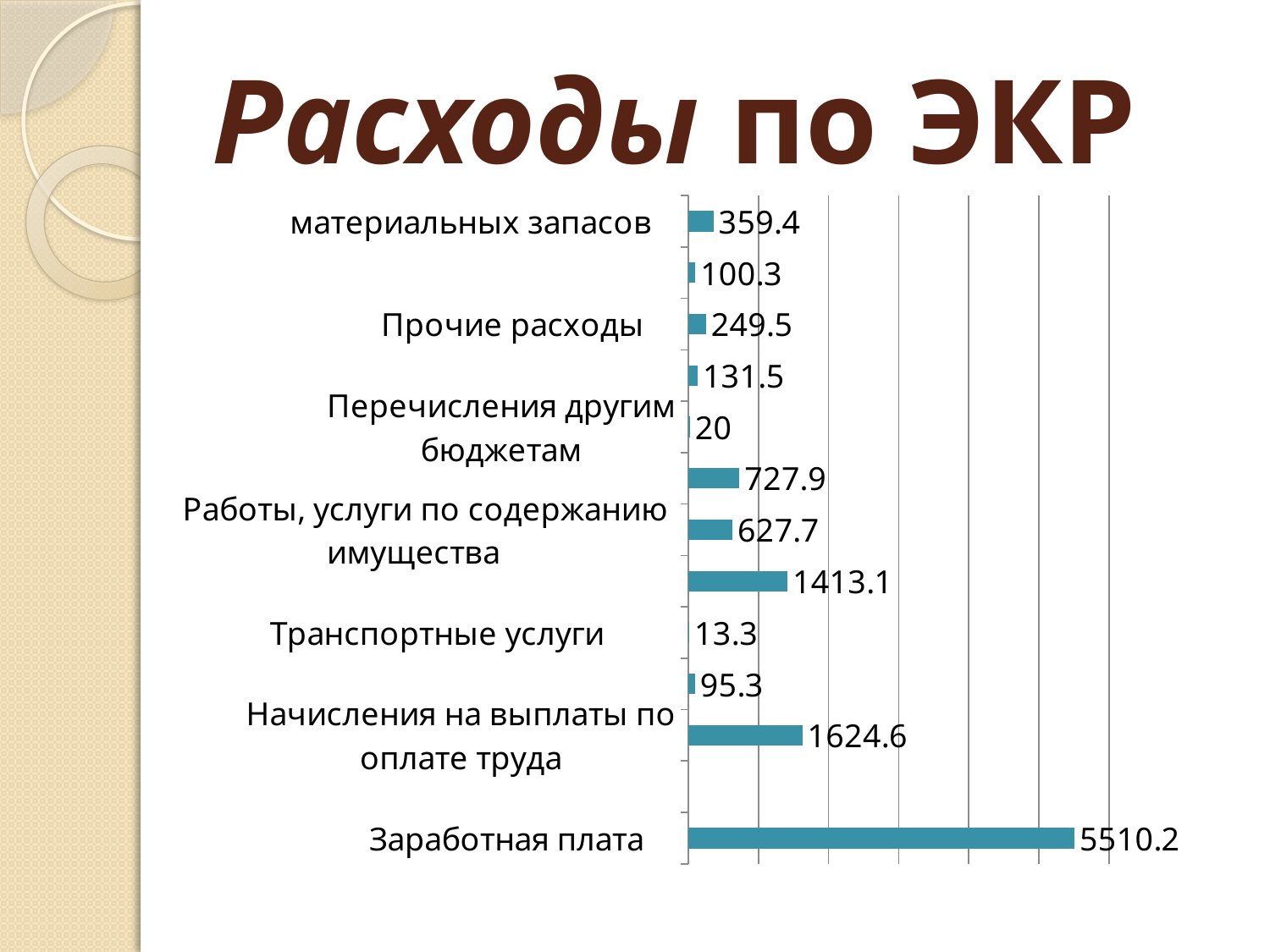
What is the difference between Заработная плата and Начисления на выплаты по оплате труда? 3885.6 What is the value for Начисления на выплаты по оплате труда? 1624.6 What is the value for Перечисления другим бюджетам? 20 What is the value for Заработная плата? 5510.2 What is the value for Работы, услуги по содержанию имущества? 627.7 Which category has the lowest value? Транспортные услуги What type of chart is shown on the slide? Bar chart What is the value for Прочие расходы? 249.5 How many bars are plotted in the chart? 12 What is the value for Транспортные услуги? 13.3 Which category has the highest value? Заработная плата Which is larger, Прочие расходы or Работы, услуги по содержанию имущества? Работы, услуги по содержанию имущества